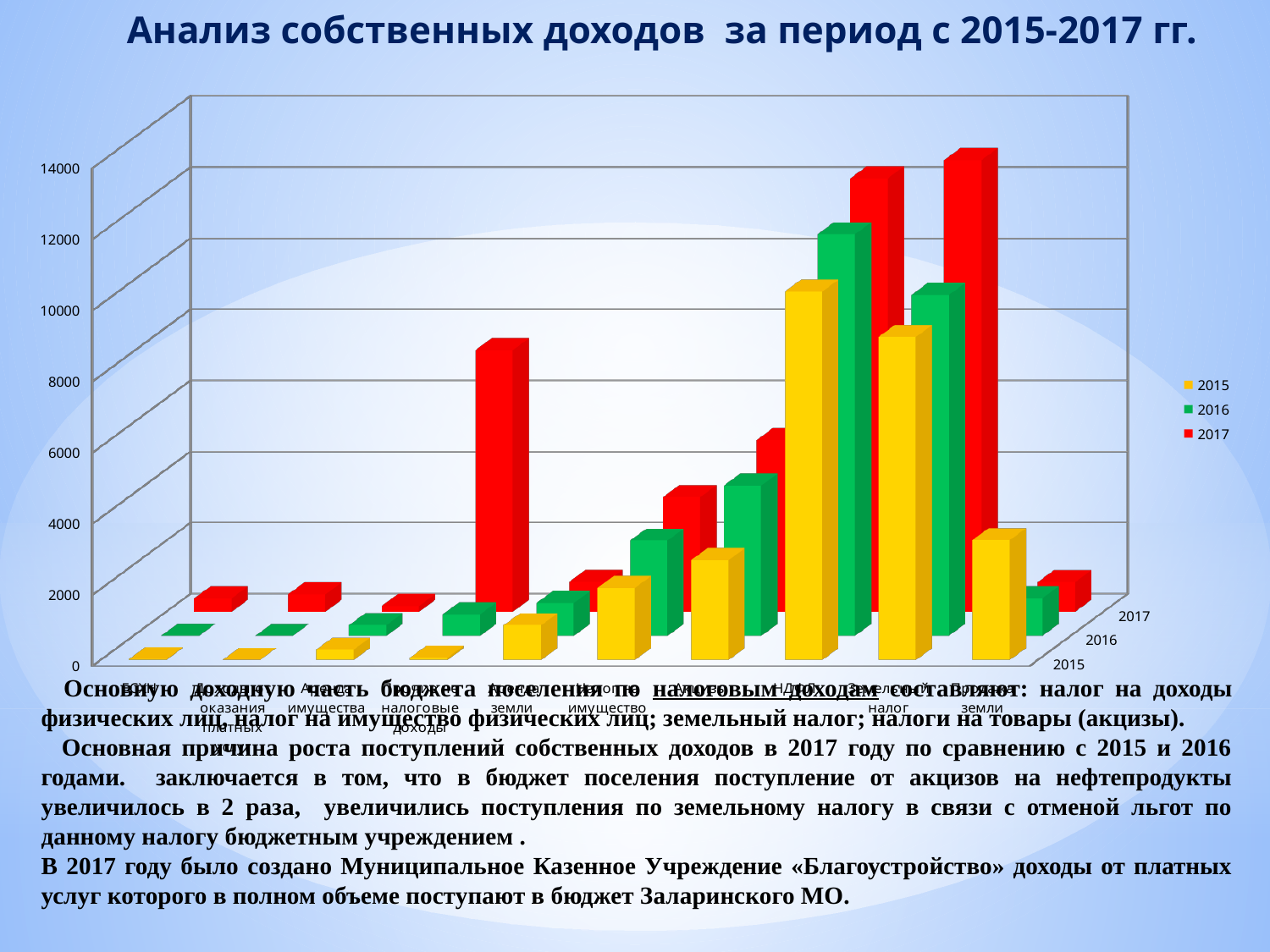
Is the tallest 2017 bar greater or less than 12000? greater What is the title of the chart? Анализ собственных доходов за период с 2015-2017 гг. Is the tallest 2016 bar greater or less than 10000? greater What are the entries in the chart legend? 2015, 2016, 2017 How many categories are plotted along the x axis of the chart? 10 Which series contains the tallest bar in the chart? 2017 In the rightmost category, which series has the tallest bar? 2015 What kind of chart is shown on the slide? bar chart What is the highest value shown on the vertical axis? 14000 How many series does the legend list? 3 Is the tallest 2015 bar greater or less than 8000? greater